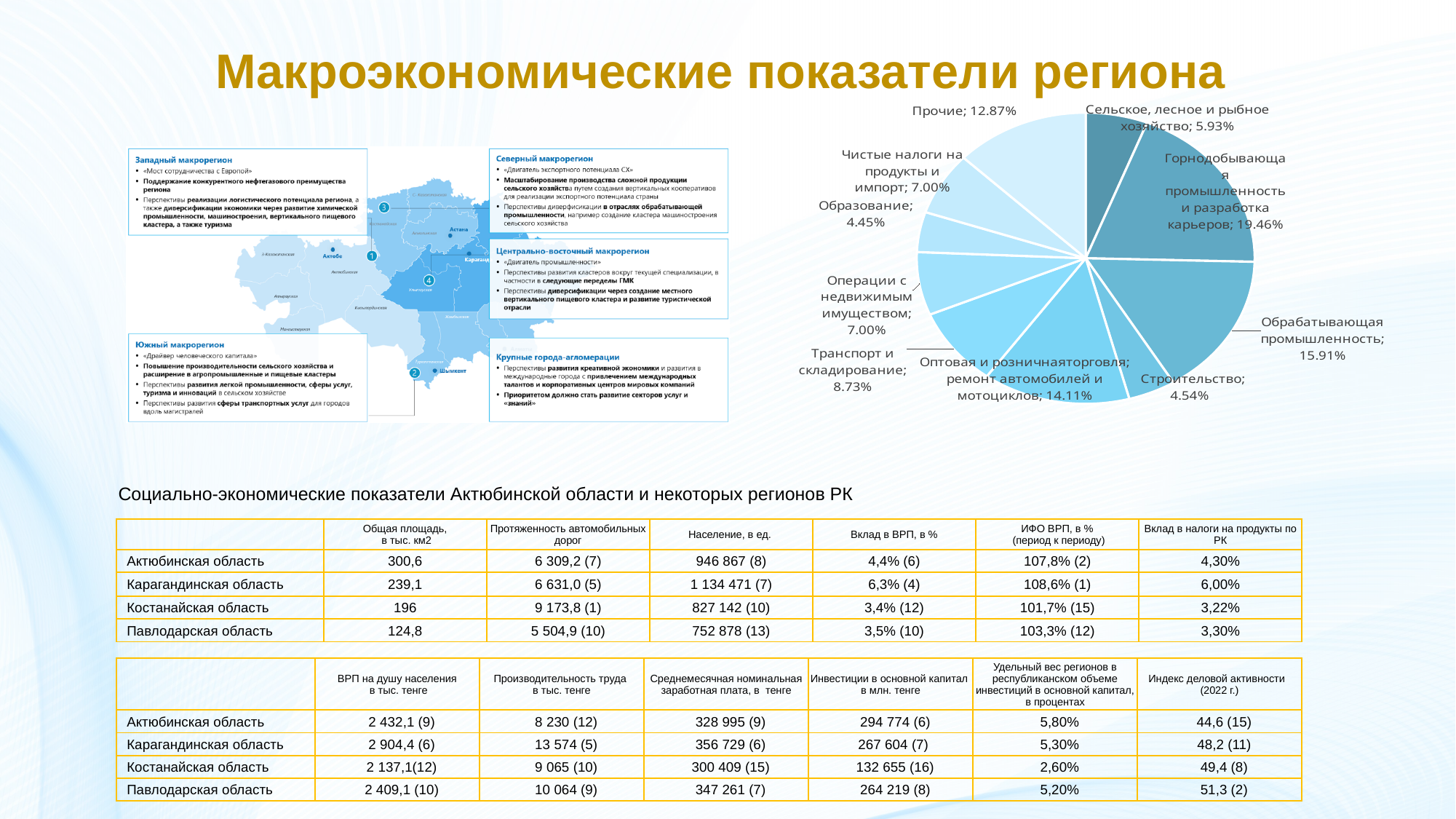
What is the difference between the shares of Горнодобывающая промышленность и разработка карьеров and Обрабатывающая промышленность? 3.55% Which slice of the pie chart is the largest? Горнодобывающая промышленность и разработка карьеров How many slices does the pie chart have? 10 What percentage is shown for Транспорт и складирование? 8.73% What is the value shown for Обрабатывающая промышленность in the pie chart? 15.91% Which slice of the pie chart is the smallest? Образование Which is larger in the pie chart: Оптовая и розничная торговля; ремонт автомобилей и мотоциклов or Прочие? Оптовая и розничная торговля; ремонт автомобилей и мотоциклов What kind of chart is shown on the slide? pie chart What is the combined share of Чистые налоги на продукты и импорт and Операции с недвижимым имуществом? 14.00% What is the value for Прочие in the pie chart? 12.87% What share of the pie does Сельское, лесное и рыбное хозяйство represent? 5.93% What share of the pie does Горнодобывающая промышленность и разработка карьеров have? 19.46%